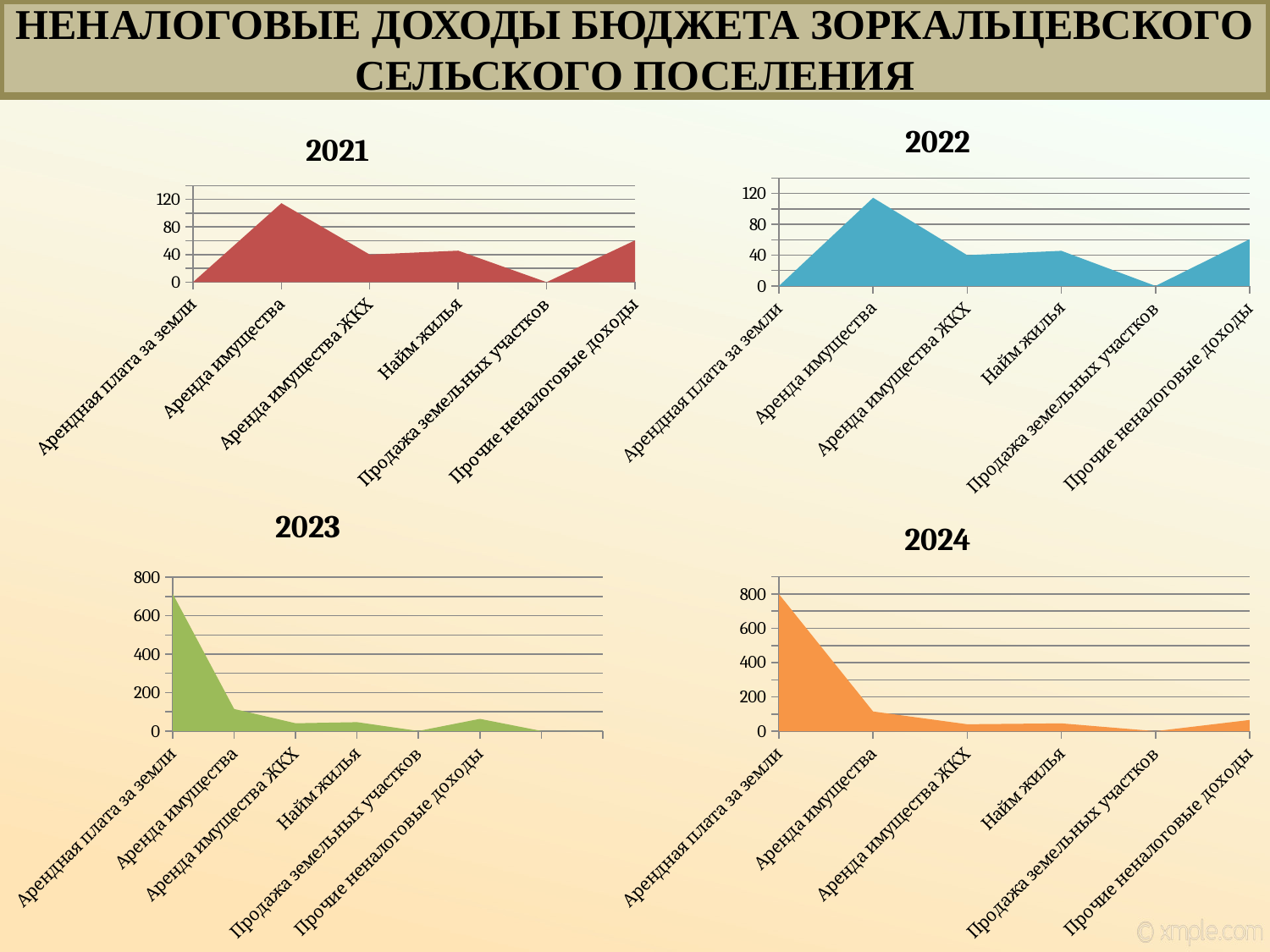
In the 2023 chart, is the value for Арендная плата за землю greater or less than 600? greater In the 2021 chart, is the value for Аренда имущества greater or less than 80? greater In the 2022 chart, is the value for Аренда имущества ЖКХ greater or less than 80? less How many charts are shown on the slide? 4 How many categories are shown on the x axis of the 2022 chart? 6 In the 2022 chart, which is larger: Аренда имущества or Прочие неналоговые доходы? Аренда имущества In the 2023 chart, which category has the highest value? Арендная плата за земли In the 2024 chart, which category has the lowest value? Продажа земельных участков What kind of chart is the 2021 chart? Area chart In the 2021 chart, which category has the highest value? Аренда имущества In the 2024 chart, which is larger: Арендная плата за землю or Аренда имущества? Арендная плата за земли